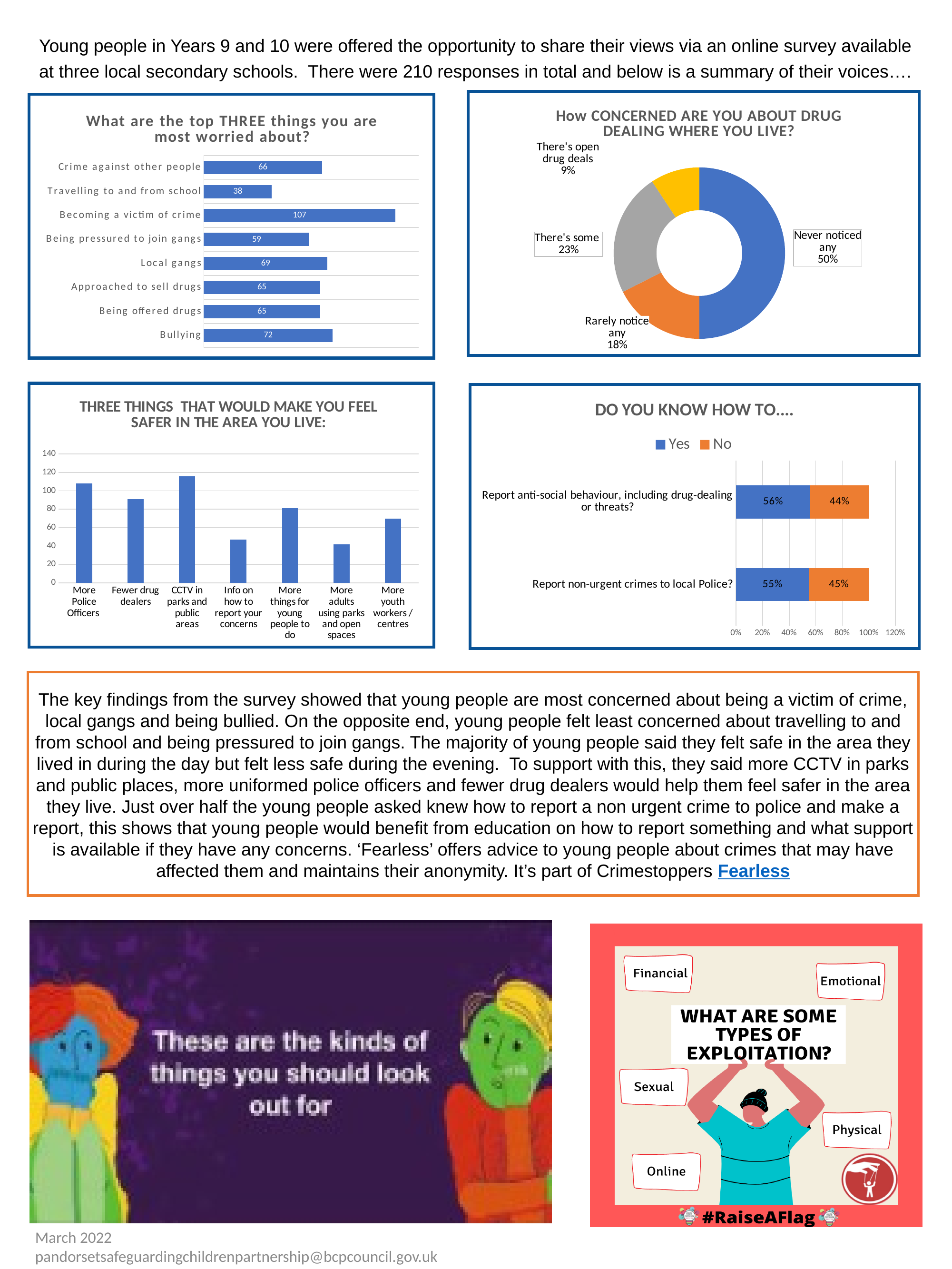
In the chart 'What are the top THREE things you are most worried about?', what is the value for Becoming a victim of crime? 107 In the chart 'How CONCERNED ARE YOU ABOUT DRUG DEALING WHERE YOU LIVE?', what share is 'There's some'? 23% How many categories are shown in the chart 'What are the top THREE things you are most worried about?' 8 In the chart 'What are the top THREE things you are most worried about?', which category has the lowest value? Travelling to and from school How many series does the legend list in the chart 'DO YOU KNOW HOW TO....'? 2 In the chart 'DO YOU KNOW HOW TO....', what percentage answered Yes to 'Report non-urgent crimes to local Police?' 55% In the chart 'THREE THINGS THAT WOULD MAKE YOU FEEL SAFER IN THE AREA YOU LIVE', which category has the highest bar? CCTV in parks and public areas In the chart 'What are the top THREE things you are most worried about?', what is the difference between Bullying and Local gangs? 3 In the chart 'THREE THINGS THAT WOULD MAKE YOU FEEL SAFER IN THE AREA YOU LIVE', is the value for 'Info on how to report your concerns' greater or less than 60? less What kind of chart is 'How CONCERNED ARE YOU ABOUT DRUG DEALING WHERE YOU LIVE?' Doughnut chart In the chart 'How CONCERNED ARE YOU ABOUT DRUG DEALING WHERE YOU LIVE?', which response has the largest share? Never noticed any How many categories are shown in the chart 'THREE THINGS THAT WOULD MAKE YOU FEEL SAFER IN THE AREA YOU LIVE'? 7